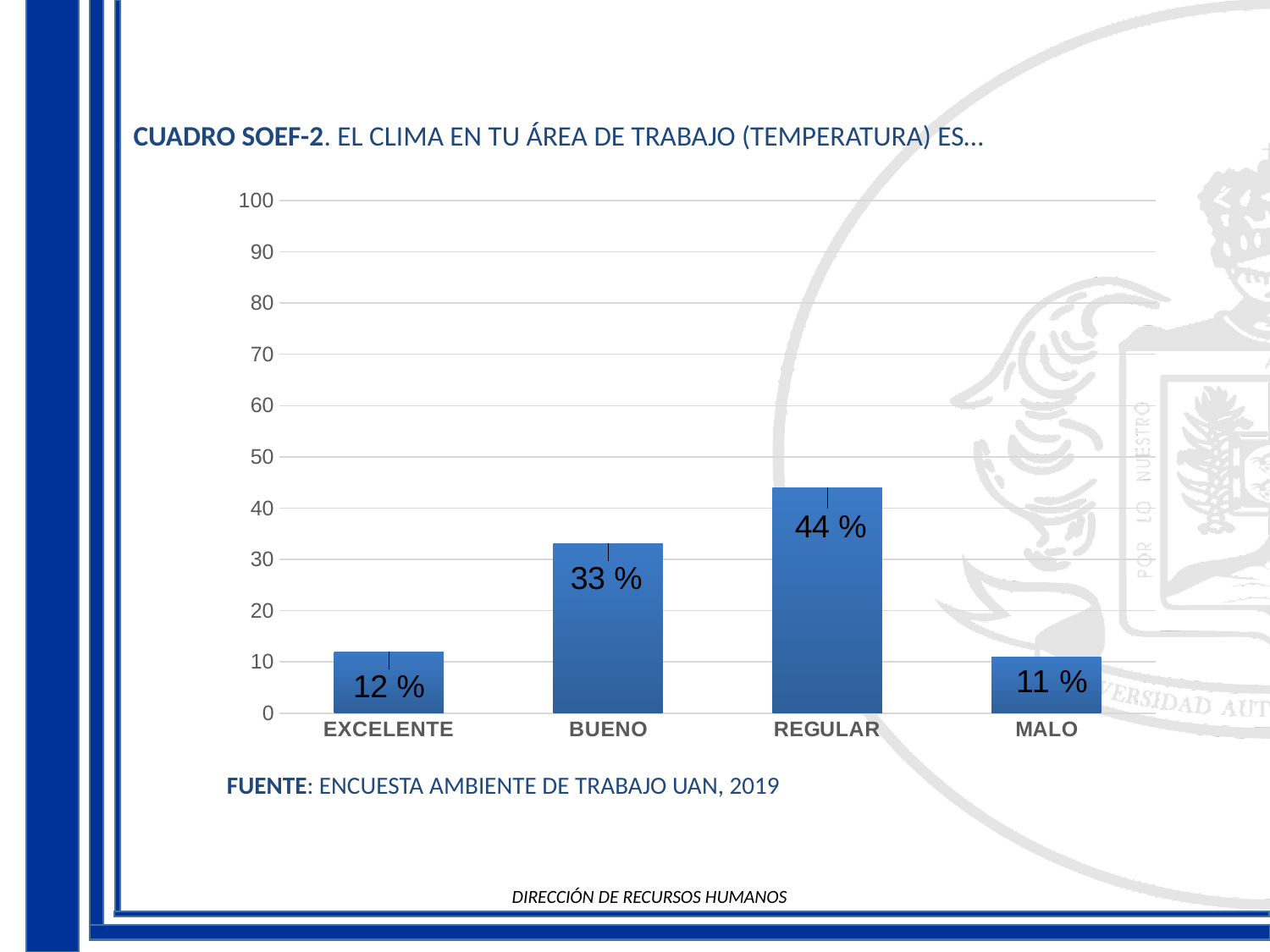
How many categories are shown on the x axis? 4 What is the value for EXCELENTE? 12 % Is the value for BUENO greater or less than 40? less Which is larger, the value for BUENO or the value for EXCELENTE? BUENO What is the difference between the values for REGULAR and BUENO? 11 % Which category has the lowest value? MALO What is the value for BUENO? 33 % Which category has the highest value? REGULAR What kind of chart is shown on the slide? bar chart What is the source cited below the chart? ENCUESTA AMBIENTE DE TRABAJO UAN, 2019 What is the value for MALO? 11 % What is the value for REGULAR? 44 %